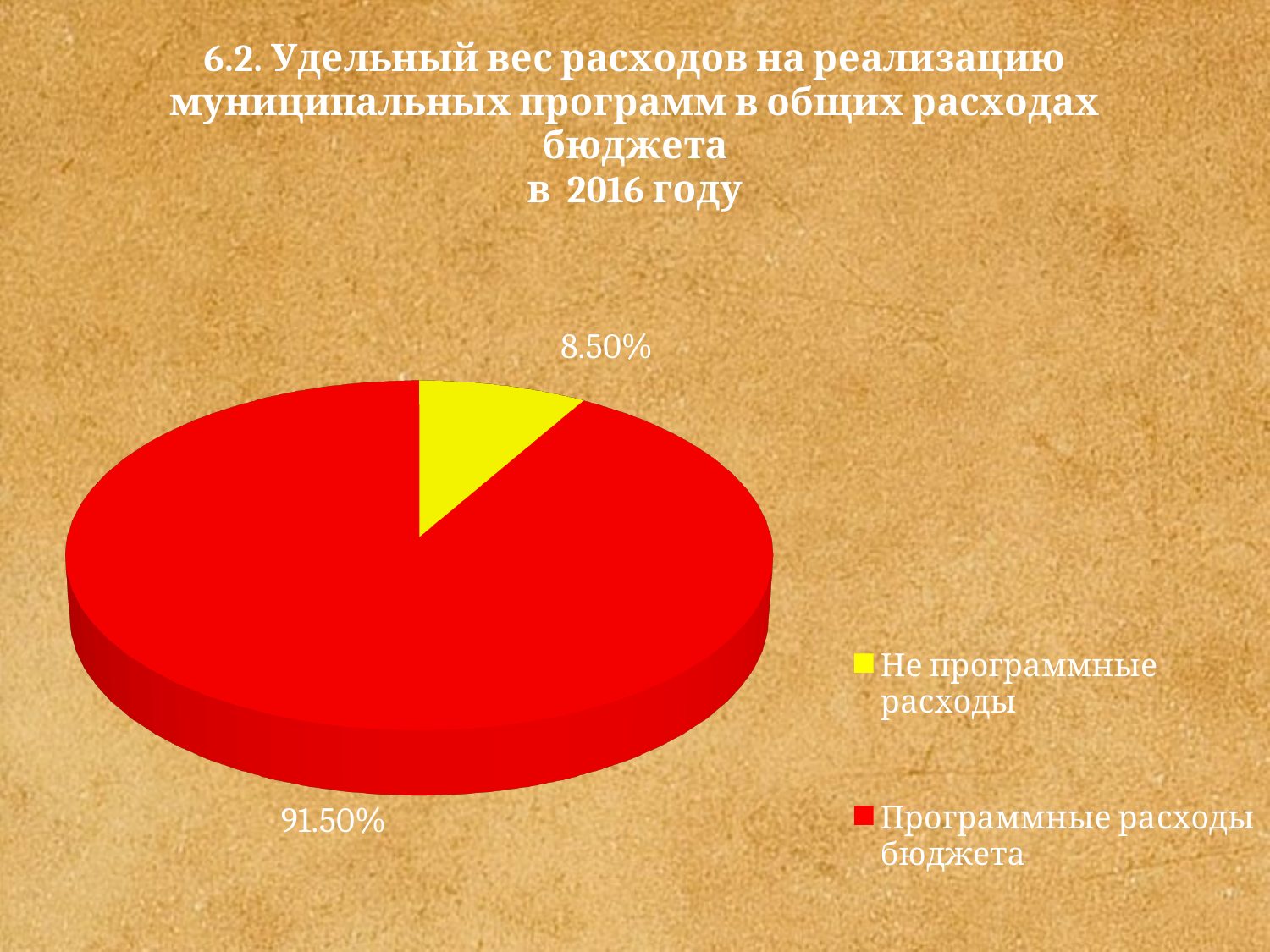
Which category has the largest share of the pie? Программные расходы бюджета Which category has the smallest share of the pie? Не программные расходы What is the value for Не программные расходы? 8.50% Which is larger: Не программные расходы or Программные расходы бюджета? Программные расходы бюджета How many entries does the legend list? 2 What is the difference between the shares of Программные расходы бюджета and Не программные расходы? 83.00% What is the value for Программные расходы бюджета? 91.50% How many slices does the pie chart have? 2 What colour is the slice for Не программные расходы? yellow What colour is the slice for Программные расходы бюджета? red What share of the pie does Не программные расходы take? 8.50% What kind of chart is shown on the slide? pie chart